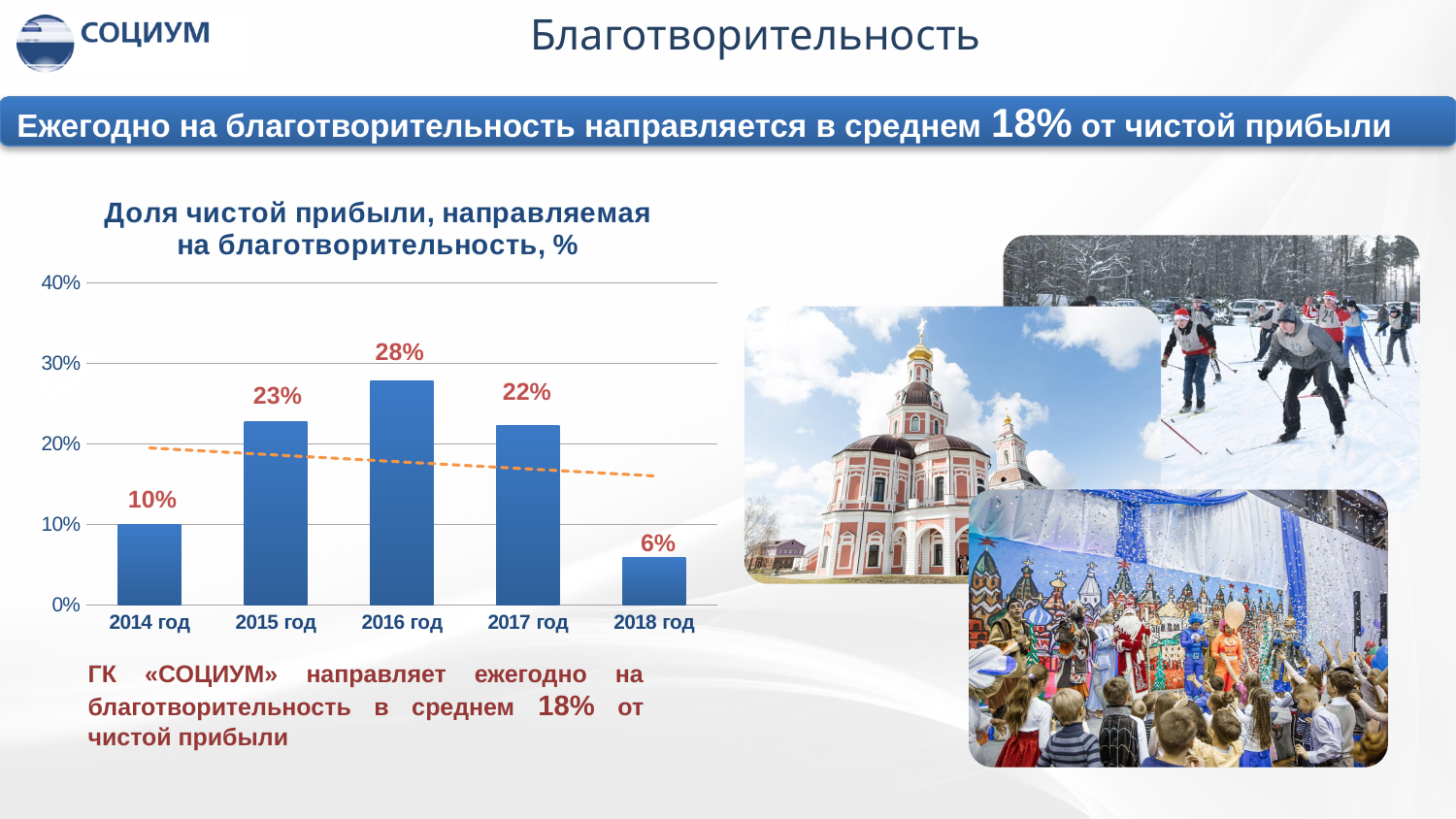
How many years are shown on the chart? 5 Which year has the lowest share of net profit directed to charity? 2018 год Is the value for 2017 год greater or less than 20%? greater What is the difference between the values for 2015 год and 2017 год? 1% What is the title of the chart? Доля чистой прибыли, направляемая на благотворительность, % What kind of chart is shown on the slide? bar chart What is the difference between the values for 2016 год and 2018 год? 22% What is the value for 2016 год? 28% What is the value for 2014 год? 10% What is the value for 2018 год? 6% Which year has the highest share of net profit directed to charity? 2016 год Which is larger, the value for 2015 год or the value for 2014 год? 2015 год